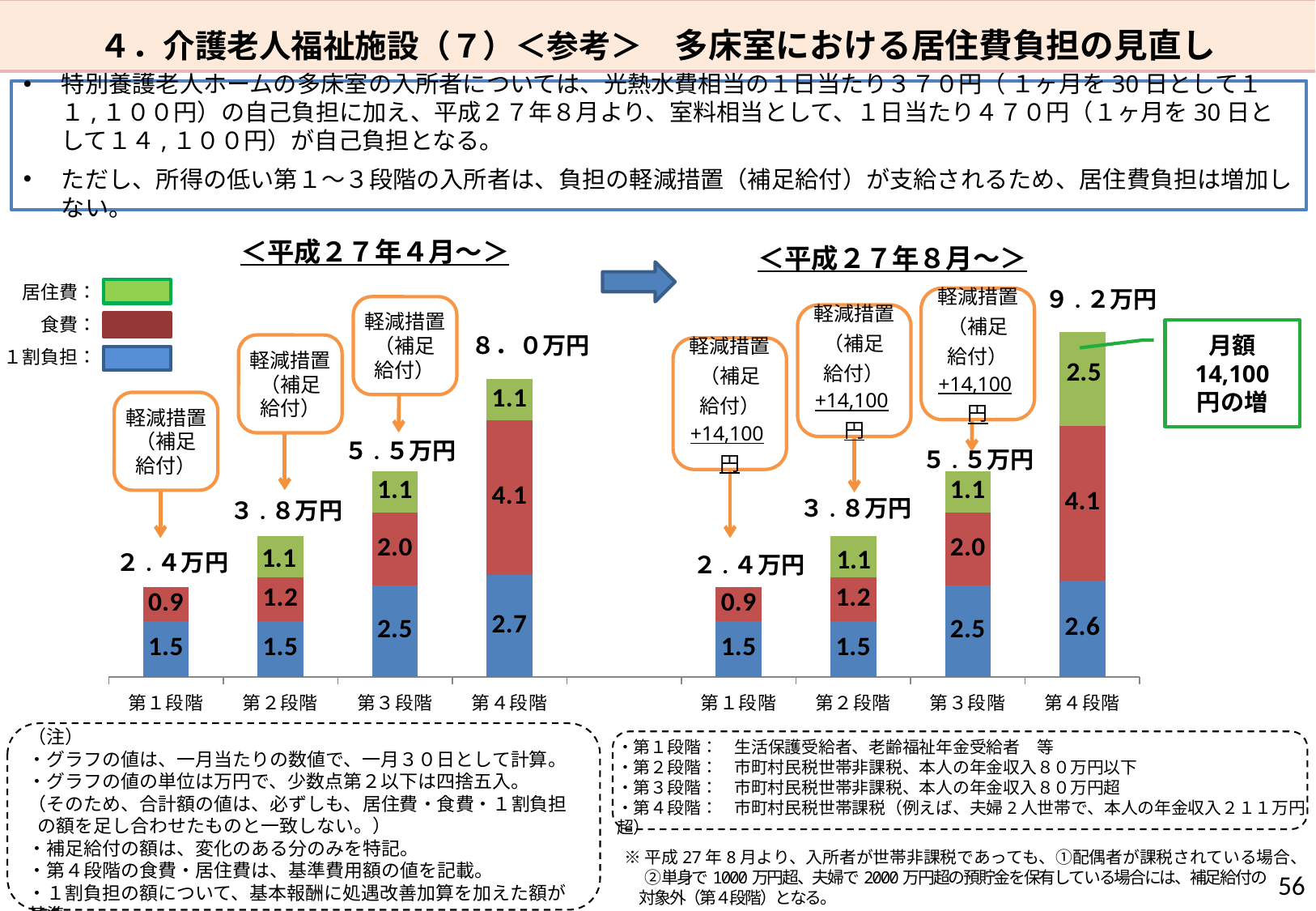
In the ＜平成２７年８月～＞ chart, what is the total labelled above the 第４段階 bar? 9.2万円 How many categories are shown on the x axis of the ＜平成２７年８月～＞ chart? 4 In the ＜平成２７年４月～＞ chart, which category has the lowest total? 第１段階 What kind of chart is the ＜平成２７年４月～＞ chart? Stacked bar chart In the ＜平成２７年８月～＞ chart, what is the 居住費 value for 第４段階? 2.5 In the ＜平成２７年４月～＞ chart, what is the １割負担 value for 第４段階? 2.7 In the ＜平成２７年８月～＞ chart, what is the 食費 value for 第３段階? 2.0 How many series does the legend list for the charts? 3 In the ＜平成２７年４月～＞ chart, what is the difference between the 食費 values for 第４段階 and 第３段階? 2.1 Which is larger: the 居住費 value for 第４段階 in the ＜平成２７年８月～＞ chart or in the ＜平成２７年４月～＞ chart? ＜平成２７年８月～＞ In the ＜平成２７年４月～＞ chart, what is the total labelled above the 第４段階 bar? 8.0万円 In the ＜平成２７年８月～＞ chart, which category has the highest total? 第４段階